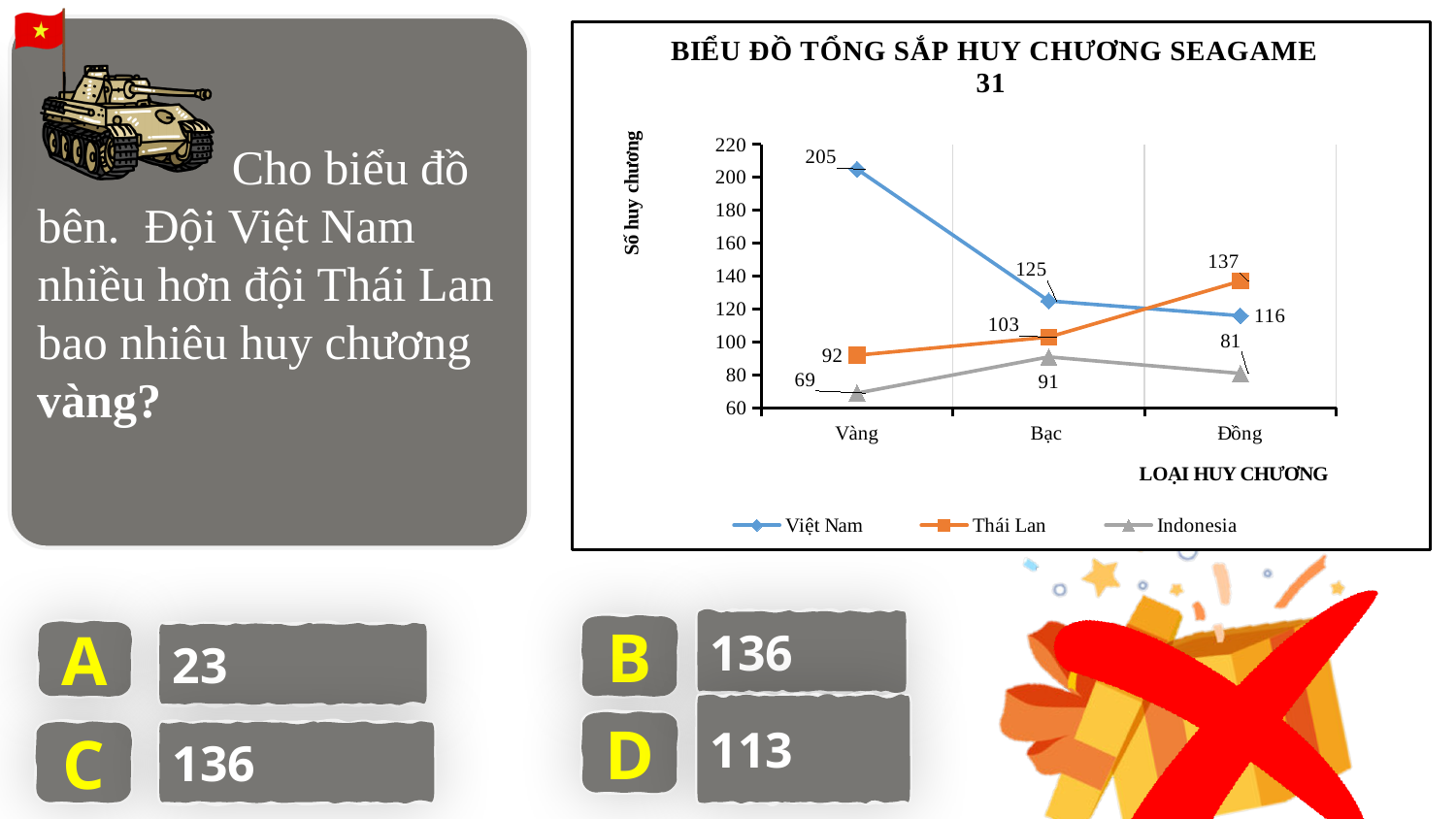
Which category has the lowest value for Indonesia? Vàng Which is larger in the Đồng category, Việt Nam or Thái Lan? Thái Lan How many series does the legend list? 3 What is the value for Indonesia in the Bạc category? 91 What is the title of the chart? BIỂU ĐỒ TỔNG SẮP HUY CHƯƠNG SEAGAME 31 Which category has the highest value for Việt Nam? Vàng What is the difference between Việt Nam and Thái Lan in the Vàng category? 113 Do the values for Thái Lan rise or fall from Vàng to Đồng? rise What is the value for Thái Lan in the Đồng category? 137 How many categories are shown on the x axis? 3 What is the value for Việt Nam in the Vàng category? 205 What type of chart is shown on the slide? line chart